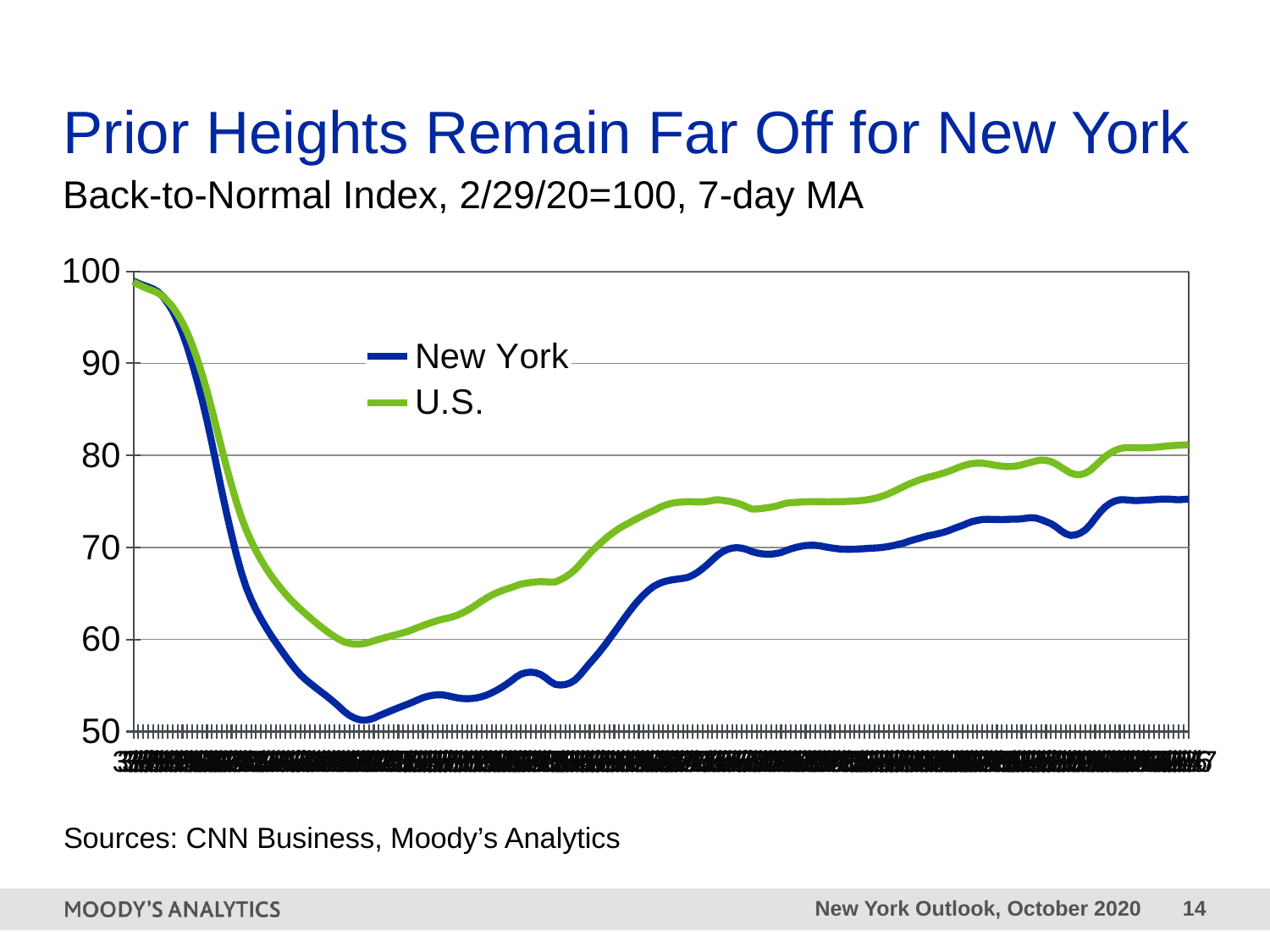
What kind of chart is shown on the slide? line chart What is the title of the chart on the slide? Prior Heights Remain Far Off for New York Is the value of the New York line at the right end of the chart greater or less than 80? less Is the value of the U.S. line at the right end of the chart greater or less than 70? greater At the right end of the chart, which series has the higher value, New York or U.S.? U.S. After reaching its lowest point, does the U.S. line generally rise or fall toward the right end of the chart? rise Which series reaches the lower minimum value, New York or U.S.? New York Which series is drawn in green? U.S. Is the lowest value of the New York line greater or less than 60? less Does the New York line end higher or lower than where it starts at the left of the chart? lower How many series does the legend list? 2